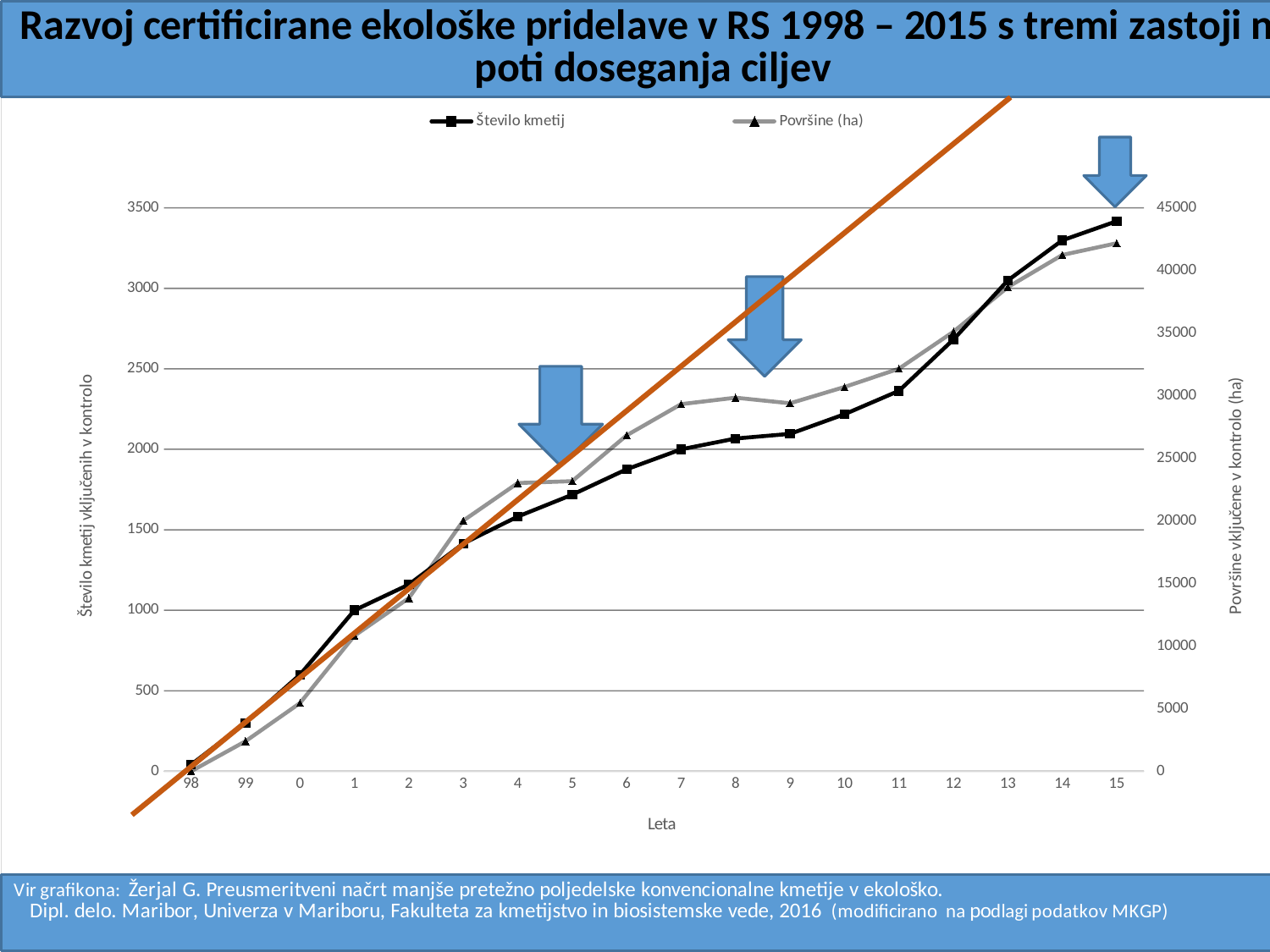
Is the value for Površine (ha) in year 99 greater or less than 5000? less Which year has the larger value for Število kmetij, 10 or 12? 12 How many series does the legend list? 2 Is the value for Število kmetij in year 15 greater or less than 3000? greater What are the two series named in the legend? Število kmetij and Površine (ha) Do the values for Število kmetij rise or fall from 98 to 15? rise In which year is the value for Število kmetij highest? 15 What kind of chart is shown on the slide? line chart Is the value for Površine (ha) in year 15 greater or less than 40000? greater In which year is the value for Površine (ha) lowest? 98 How many years (points) are plotted along the x axis? 18